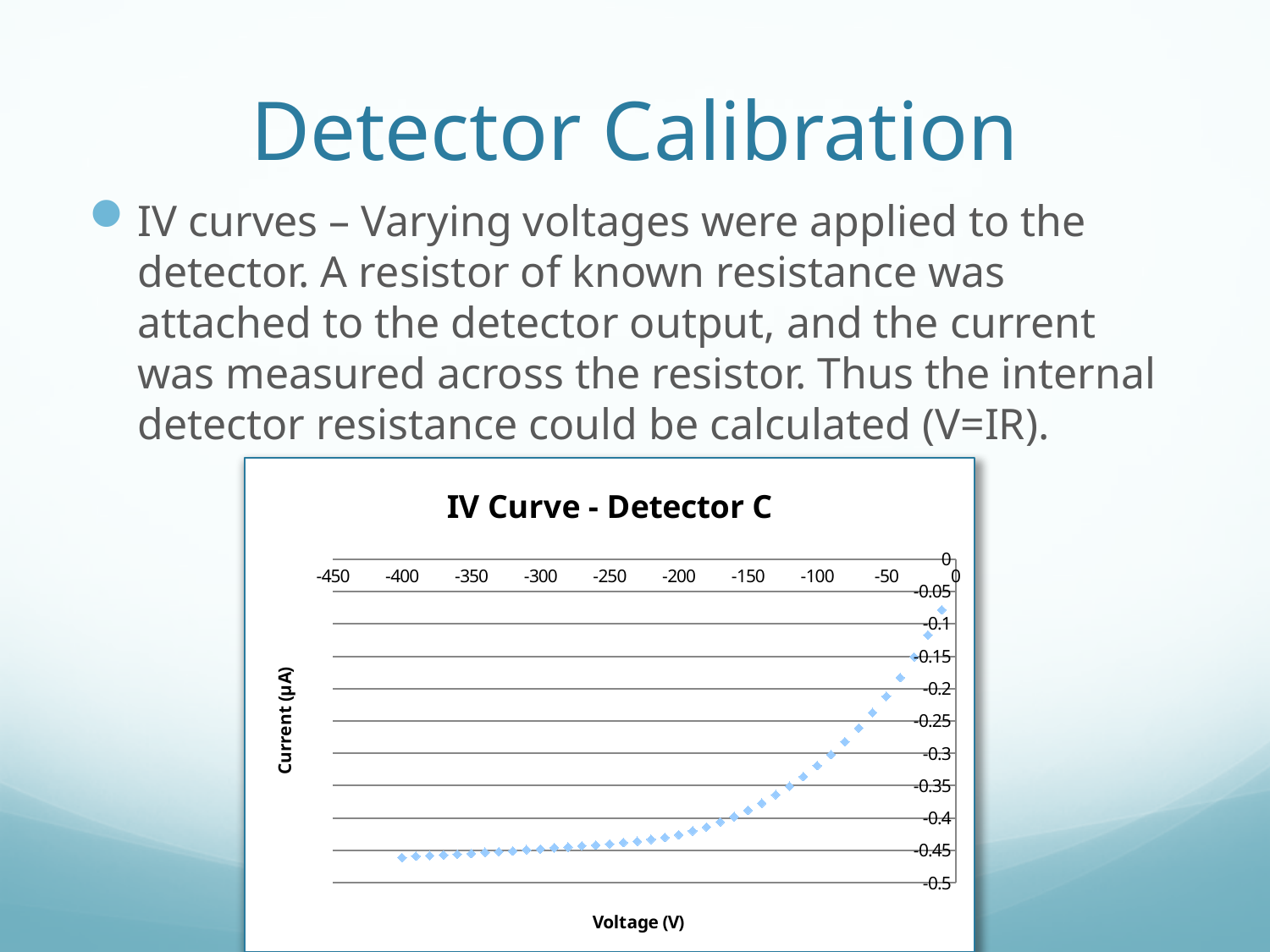
At which end of the voltage range is the current lowest (most negative)? -400 V As the voltage increases from -400 V toward 0 V, does the current rise or fall? Rise Which has the lower current, the point at -350 V or the point at -150 V? -350 V Is the current at -50 V greater or less than -0.3? greater What is the title of the chart? IV Curve - Detector C Is the current at -200 V greater or less than -0.4? less Is the current at -100 V greater or less than -0.35? greater What are the x-axis and y-axis labels of the chart? Voltage (V) and Current (µA) Which has the higher current, the point at -100 V or the point at -300 V? -100 V What kind of chart is shown on the slide? Scatter chart